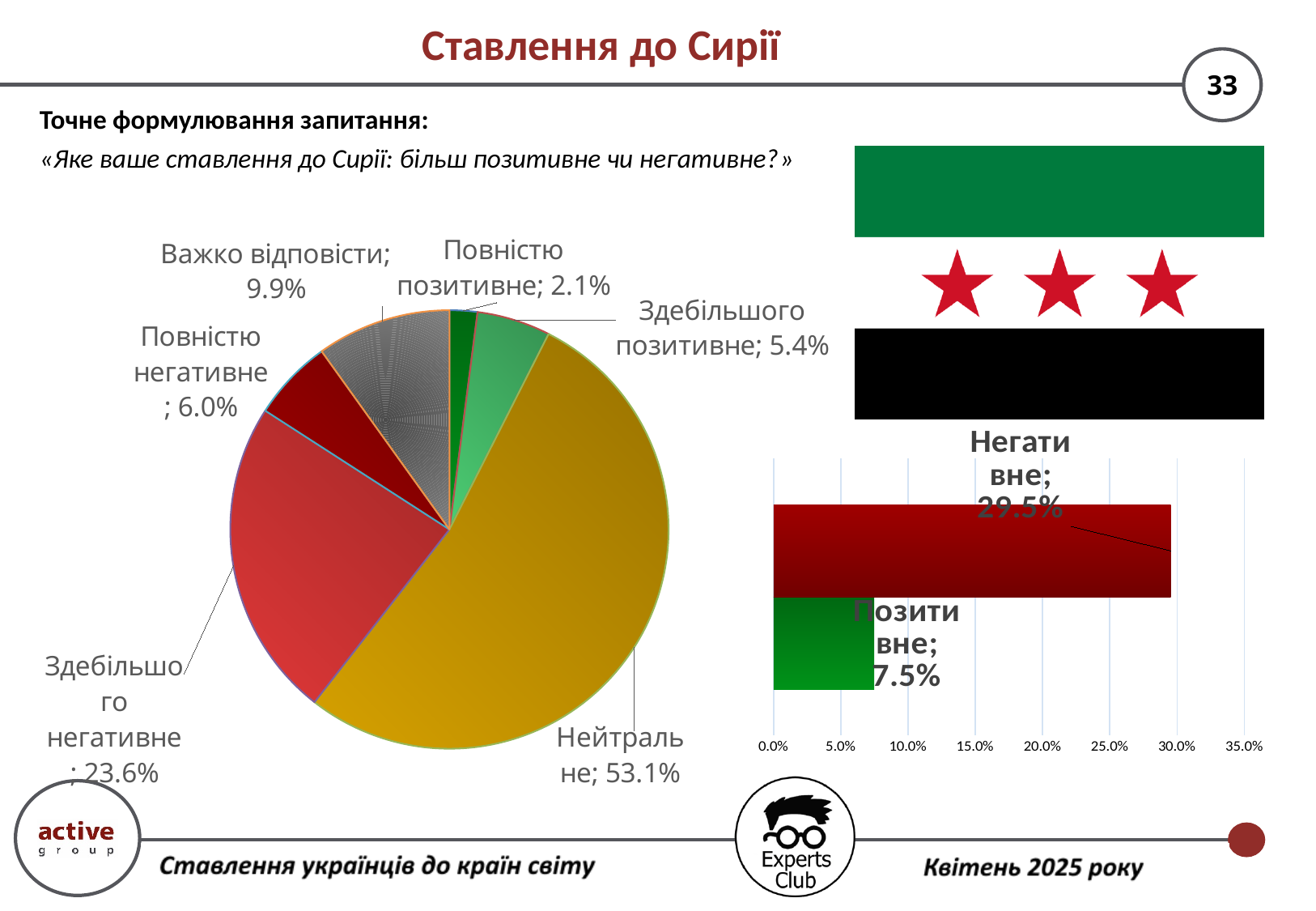
In the pie chart, which category has the smallest slice? Повністю позитивне In the pie chart, which category has the largest slice? Нейтральне In the pie chart, what share is labelled for Здебільшого негативне? 23.6% What type of chart is shown on the right side of the slide? Bar chart In the pie chart, what is the difference between Здебільшого негативне and Повністю негативне? 17.6% In the pie chart, which is larger: Здебільшого позитивне or Повністю негативне? Повністю негативне In the bar chart on the right, what is the difference between Негативне and Позитивне? 22.0% In the bar chart on the right, what is the value for Негативне? 29.5% In the pie chart, how many slices are there? 6 In the pie chart, what share is labelled for Нейтральне? 53.1% In the pie chart, what share is labelled for Важко відповісти? 9.9% In the bar chart on the right, what is the value for Позитивне? 7.5%